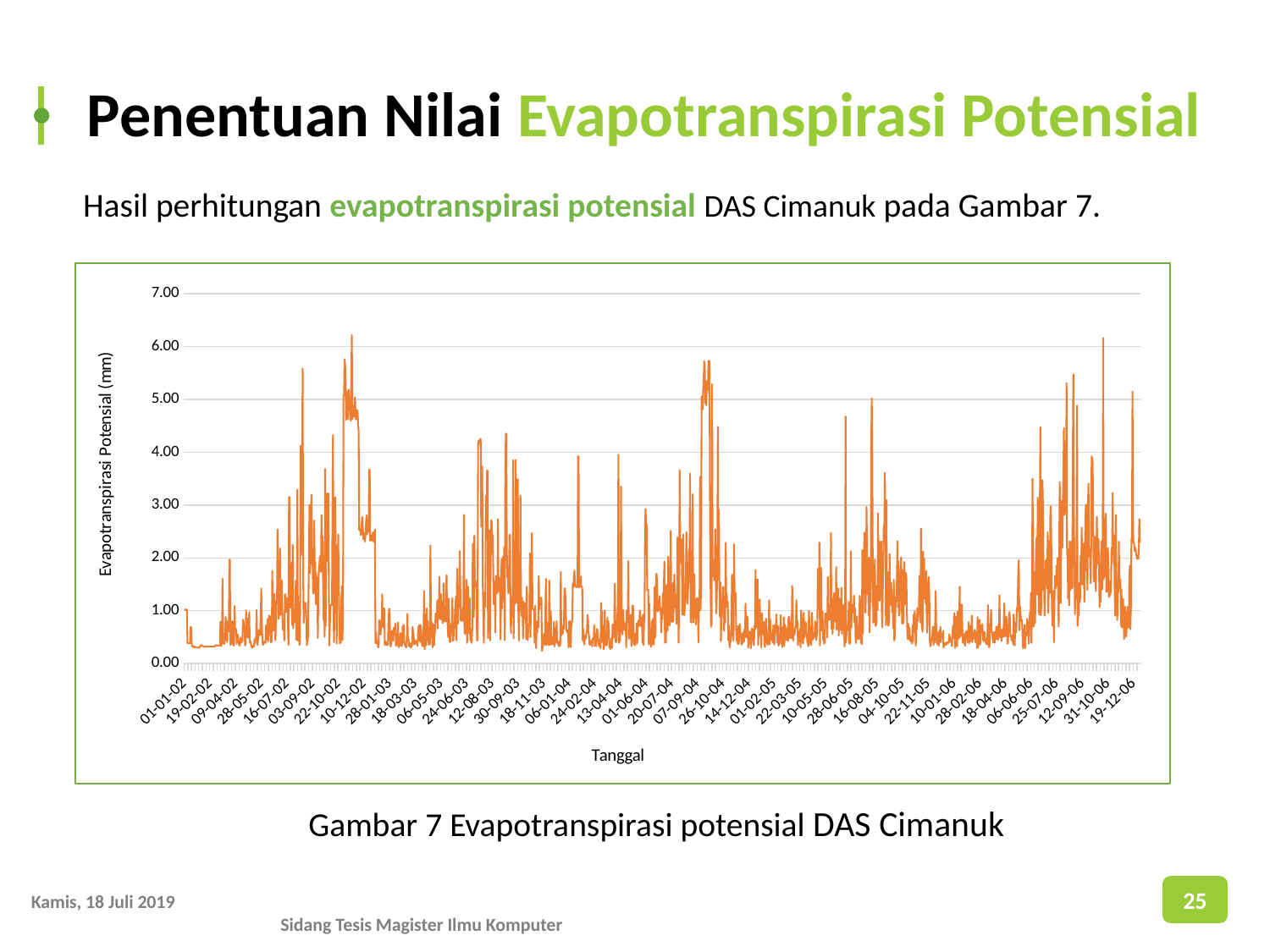
What is the first date shown on the x axis? 01-01-02 What is the label of the y axis of the chart? Evapotranspirasi Potensial (mm) Is the highest value plotted on the chart greater or less than 5.00? greater Is the peak value around 26-10-04 greater or less than 3.00? greater Is the highest value plotted on the chart greater or less than 7.00? less What is the highest tick value shown on the y axis? 7.00 What is the last date shown on the x axis? 19-12-06 What is the label of the x axis of the chart? Tanggal What kind of chart is shown on the slide? line chart How many data series are plotted on the chart? 1